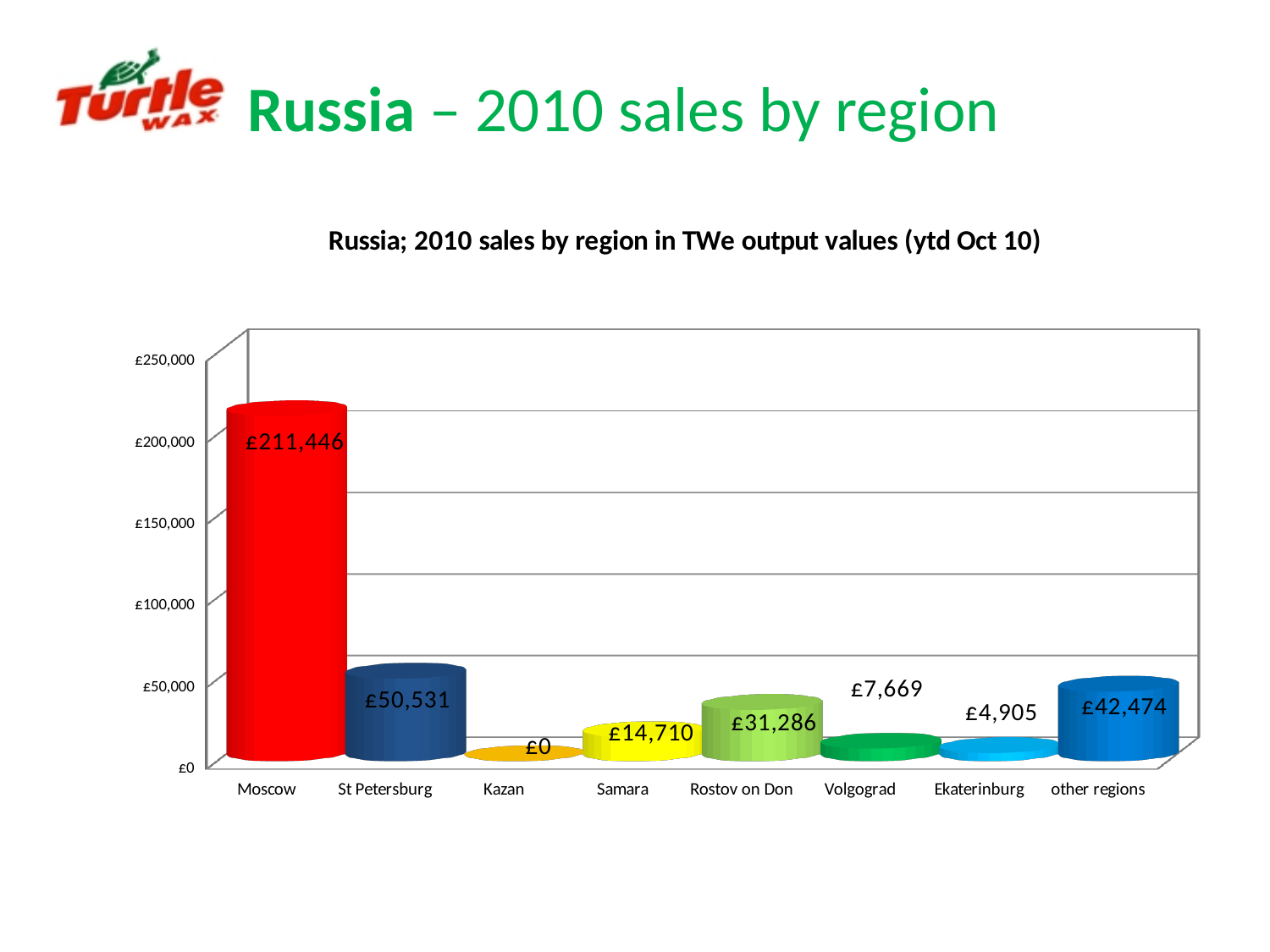
How many regions are shown on the chart? 8 What kind of chart is shown on the slide? bar chart What is the sales value for Ekaterinburg? £4,905 What is the sales value for Moscow? £211,446 What is the sales value for Rostov on Don? £31,286 What is the sales value for St Petersburg? £50,531 Which has a larger sales value, Samara or Volgograd? Samara What is the title of the chart? Russia; 2010 sales by region in TWe output values (ytd Oct 10) What is the difference between the sales values for Moscow and St Petersburg? £160,915 Which region has the highest sales value? Moscow Is the value for other regions greater or less than £50,000? less Which region has the lowest sales value? Kazan